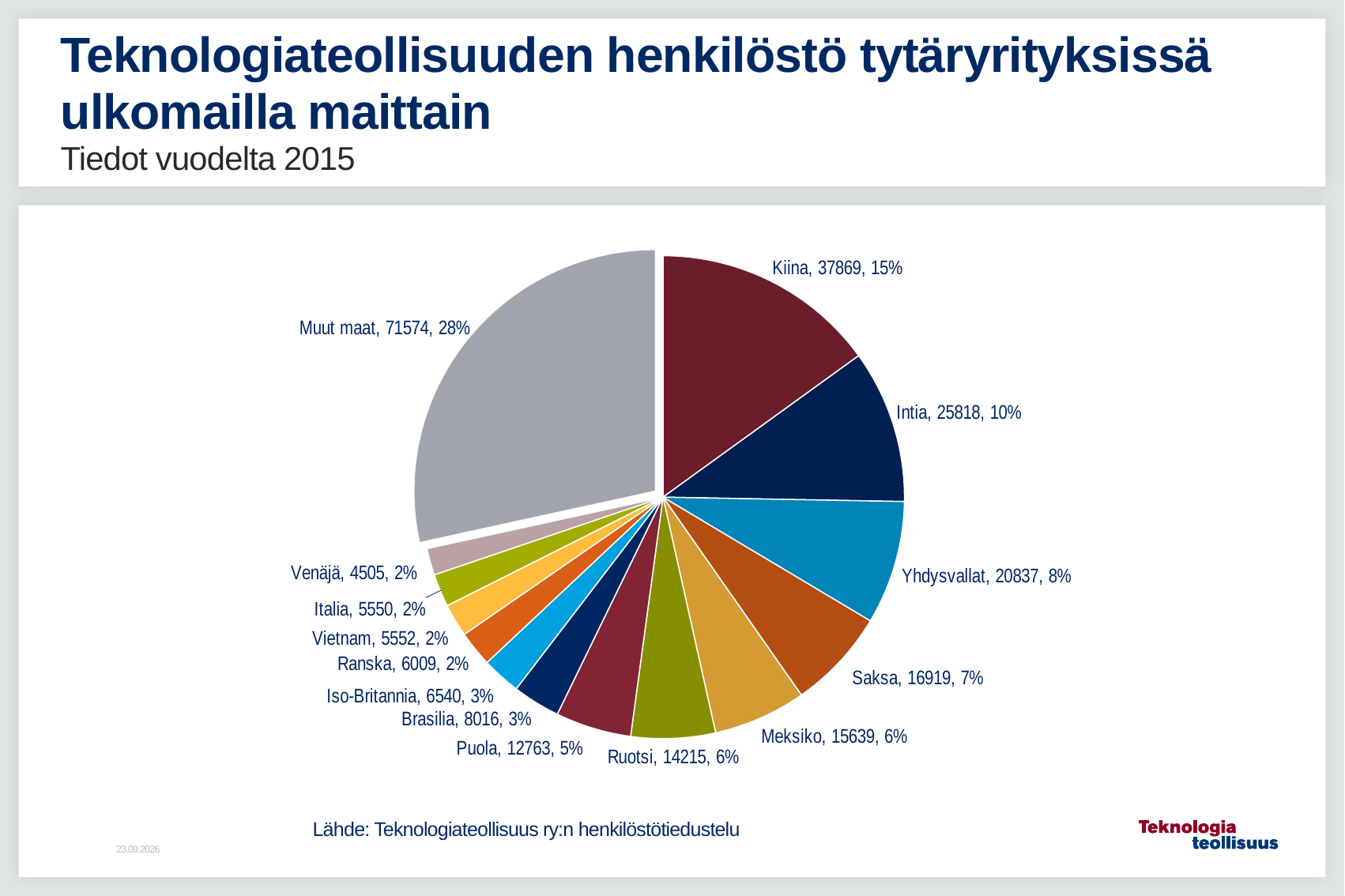
What share of the pie does Intia represent? 10% Which is larger, the value for Saksa or the value for Meksiko? Saksa What is the title of the chart on the slide? Teknologiateollisuuden henkilöstö tytäryrityksissä ulkomailla maittain What share of the pie does Muut maat represent? 28% What is the value for Yhdysvallat? 20837 How many slices does the pie chart have? 14 What kind of chart is shown on the slide? pie chart Which slice is the smallest in the pie chart? Venäjä What is the difference between the values for Kiina and Intia? 12051 What is the value for Kiina? 37869 Which slice is the largest in the pie chart? Muut maat What is the value for Puola? 12763